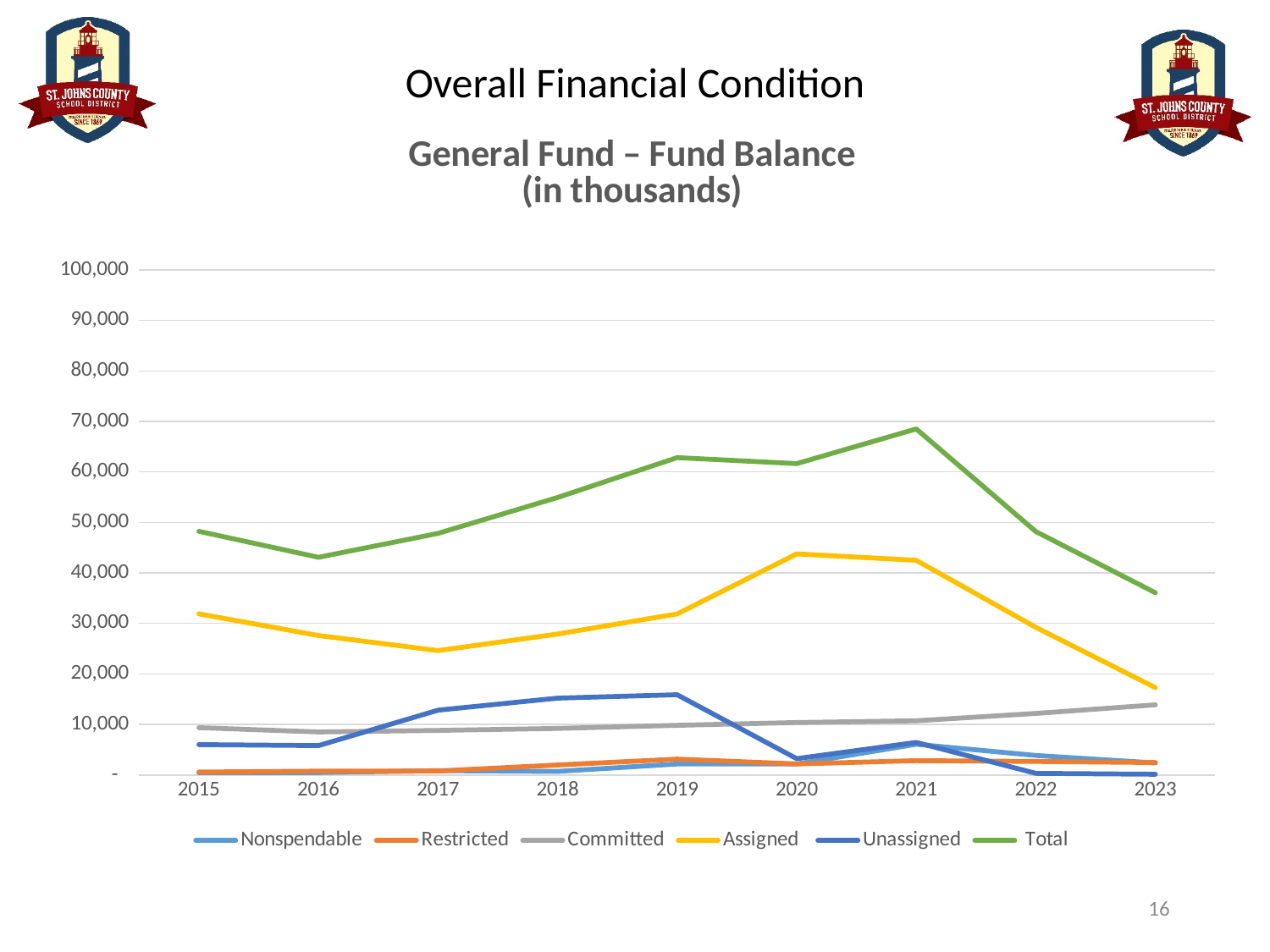
Is the Committed value for 2023 greater or less than 10,000? greater Is the Assigned value for 2020 greater or less than 40,000? greater How many years are plotted along the x axis? 9 Does the Total line rise or fall from 2021 to 2023? fall Is the Total value for 2021 greater or less than 60,000? greater In which year is the Total fund balance lowest? 2023 How many series does the legend list? 6 In which year is the Total fund balance highest? 2021 Which is larger, the Total value for 2019 or the Total value for 2016? 2019 In which year is the Assigned fund balance lowest? 2023 What kind of chart is shown on the slide? line chart